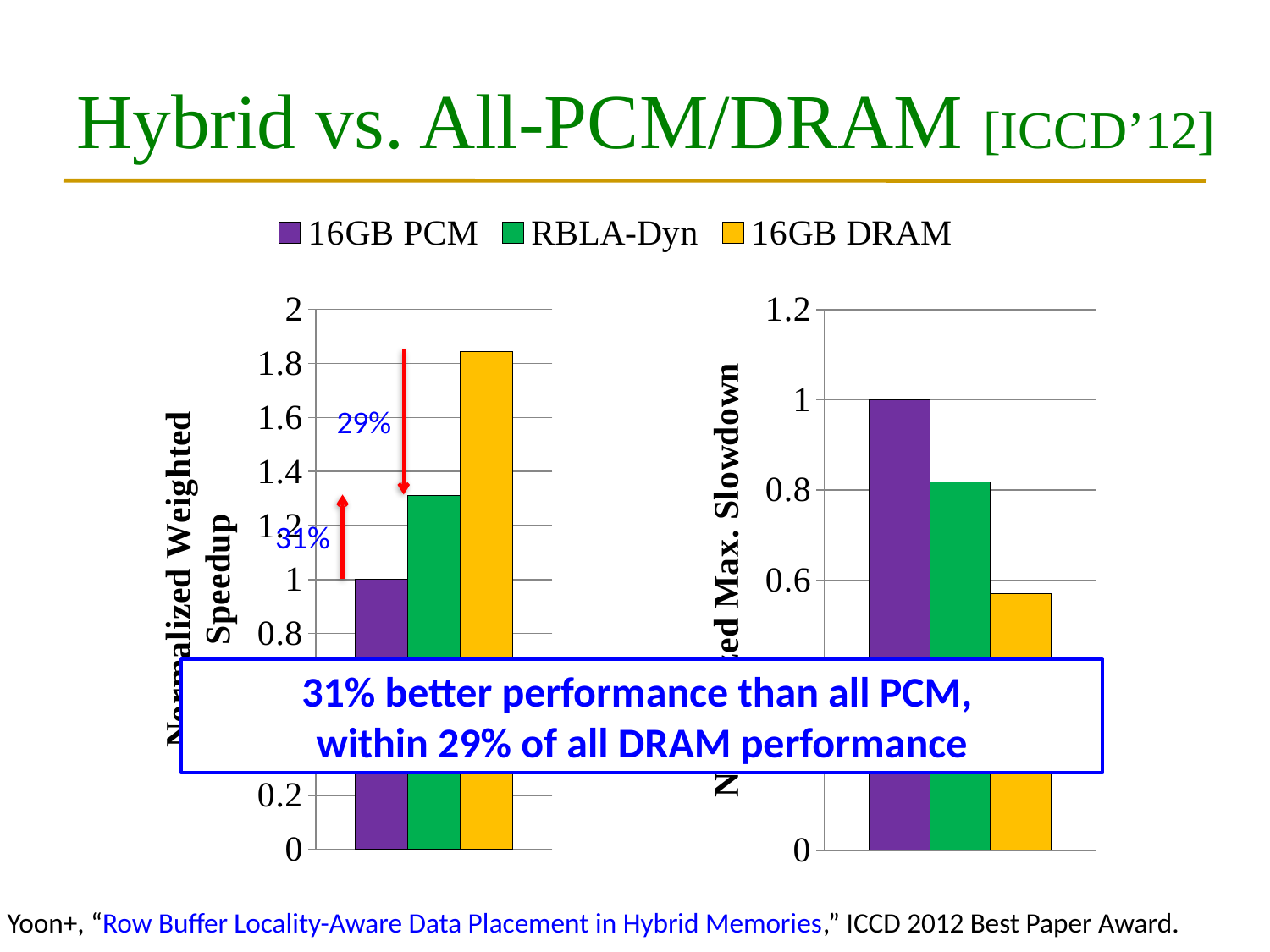
On the right chart, which series has the highest bar? 16GB PCM On the right chart, which is larger, the value for RBLA-Dyn or the value for 16GB DRAM? RBLA-Dyn On the left chart (Normalized Weighted Speedup), which series has the highest bar? 16GB DRAM On the left chart (Normalized Weighted Speedup), which series has the lowest bar? 16GB PCM On the right chart, what is the value for 16GB PCM? 1 What kind of chart is the left chart? Bar chart On the left chart (Normalized Weighted Speedup), is the value for RBLA-Dyn greater or less than 1.2? greater On the left chart (Normalized Weighted Speedup), is the value for 16GB DRAM greater or less than 1.6? greater On the right chart, which series has the lowest bar? 16GB DRAM On the left chart (Normalized Weighted Speedup), what is the value for 16GB PCM? 1 How many series does the legend list? 3 On the right chart, is the value for 16GB DRAM greater or less than 0.6? less